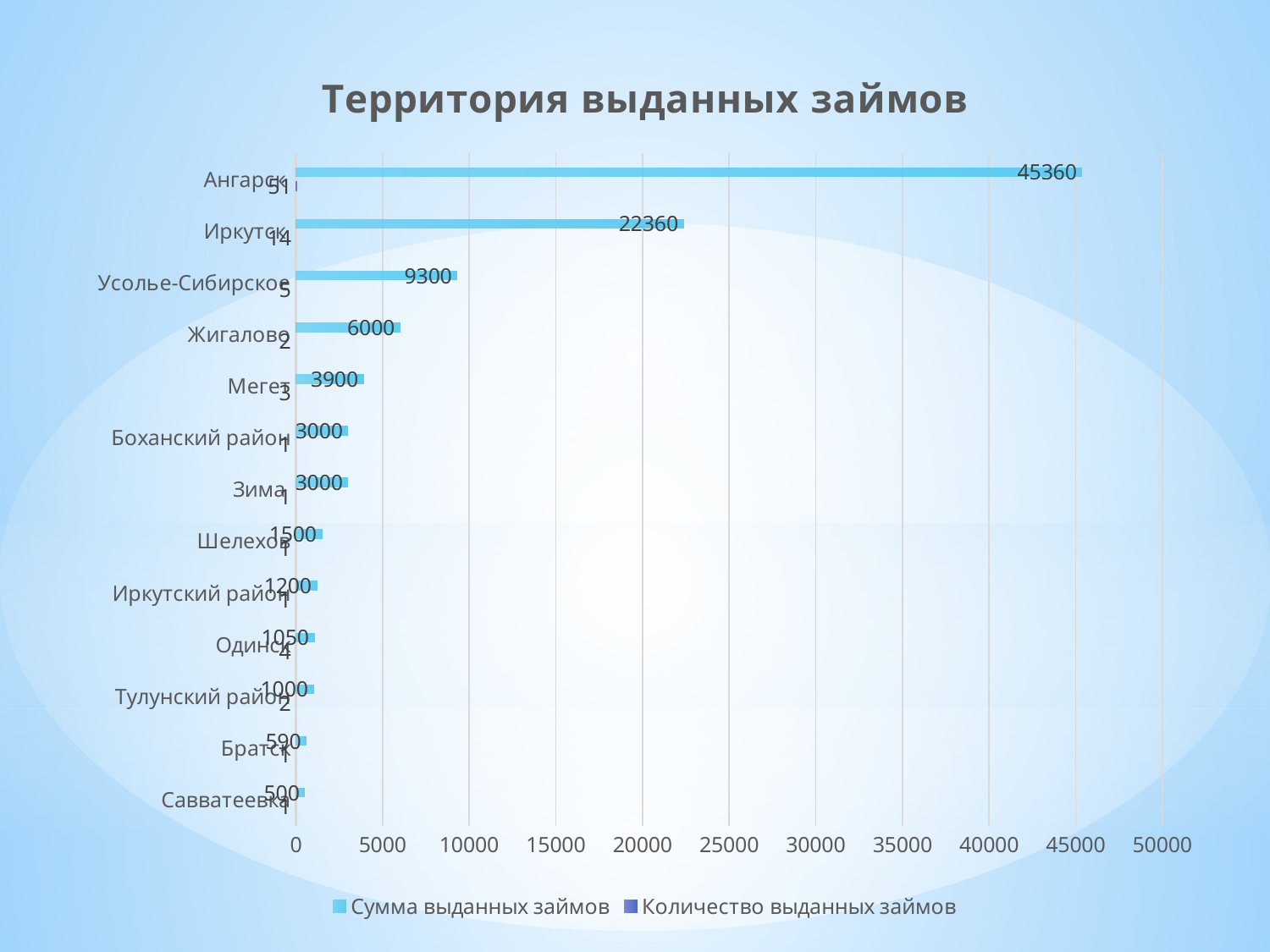
What is the title of the chart? Территория выданных займов Which territory has the lowest Сумма выданных займов? Савватеевка Which has a larger Сумма выданных займов, Жигалово or Мегет? Жигалово Which territory has the highest Сумма выданных займов? Ангарск How many territories are shown on the chart? 13 What is the value of Сумма выданных займов for Усолье-Сибирское? 9300 What is the value of Сумма выданных займов for Ангарск? 45360 Is the value of Сумма выданных займов for Иркутск greater or less than 20000? greater What is the difference in Сумма выданных займов between Ангарск and Иркутск? 23000 What is the value of Сумма выданных займов for Мегет? 3900 How many series does the legend list? 2 What kind of chart is shown on the slide? bar chart